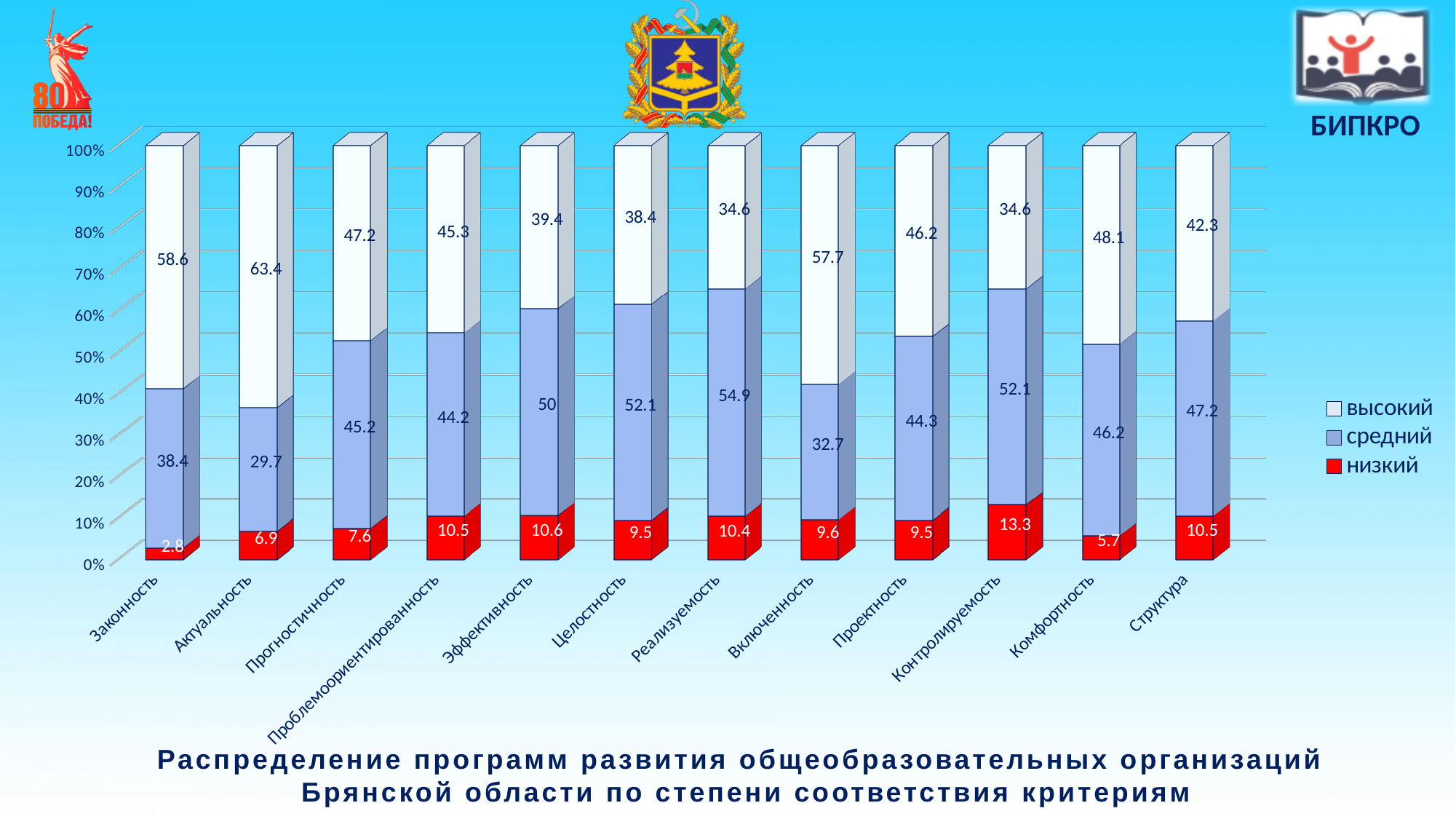
How many categories are shown on the x axis? 12 Which category has the highest value for the 'высокий' series? Актуальность Which is larger: the 'средний' value for Целостность or for Включенность? Целостность What is the difference between the 'высокий' values for Актуальность and Законность? 4.8 How many series does the legend list? 3 Which category has the highest value for the 'низкий' series? Контролируемость What is the total of the stacked bar for Актуальность? 100 What is the value of the 'высокий' series for Законность? 58.6 What is the value of the 'средний' series for Реализуемость? 54.9 What is the value of the 'низкий' series for Контролируемость? 13.3 Which category has the lowest value for the 'низкий' series? Законность What kind of chart is shown on the slide? Stacked bar chart